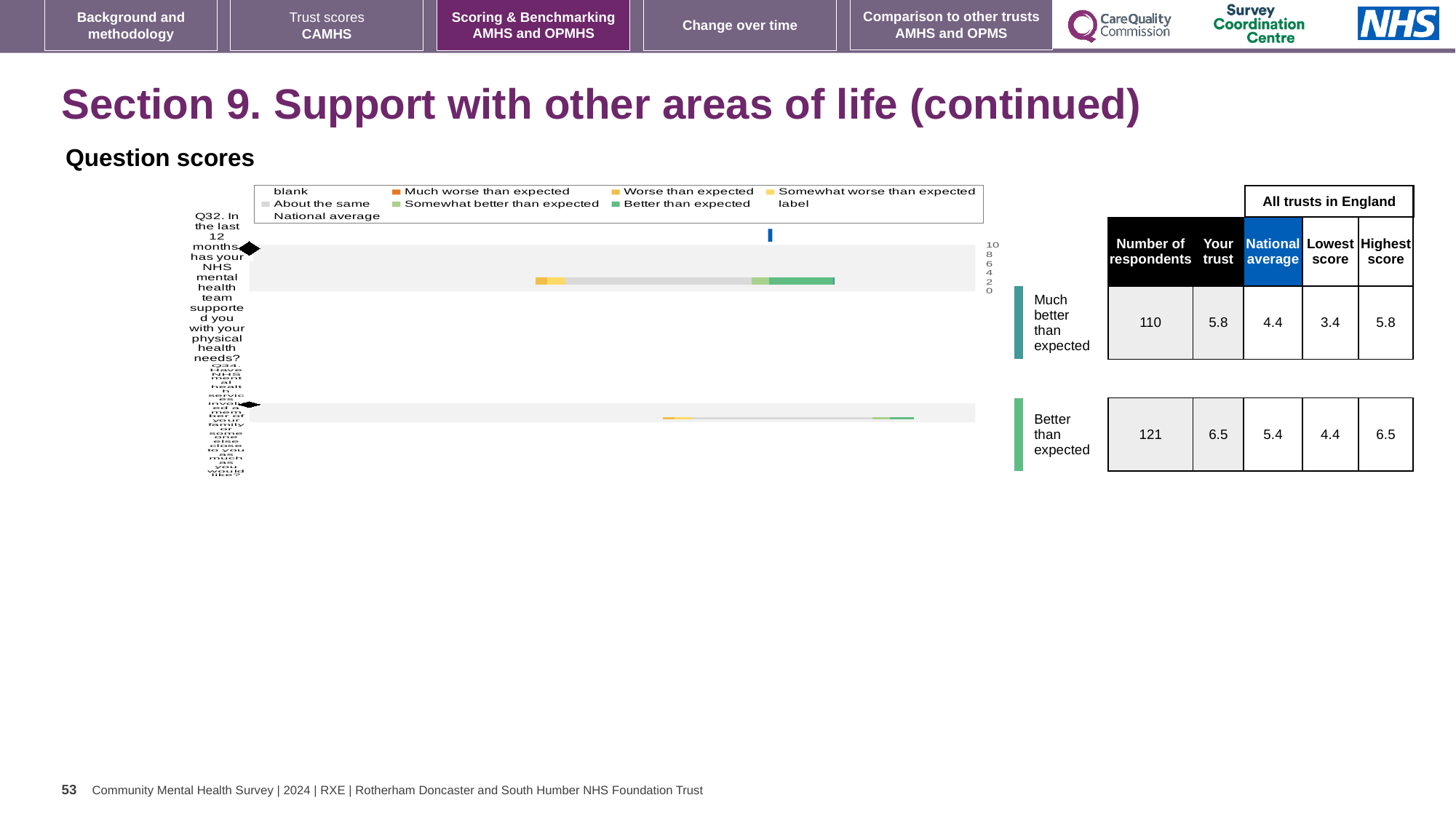
What is the highest score across all trusts in England for Q34? 6.5 What benchmark rating is shown next to the bar for Q34? Better than expected What is the lowest score across all trusts in England for Q32? 3.4 What is the national average score for Q34 (involving family or someone close)? 5.4 What is the difference between the highest and lowest scores for Q34? 2.1 By how much does the trust's score for Q32 exceed the national average for Q32? 1.4 What is the 'Your trust' score for Q32 (support with physical health needs)? 5.8 How many questions (categories) are plotted in the question scores chart? 2 What kind of chart is used to show the question scores on this slide? bar chart What benchmark rating is shown next to the bar for Q32? Much better than expected How many respondents answered Q32? 110 Which question has the higher 'Your trust' score, Q32 or Q34? Q34